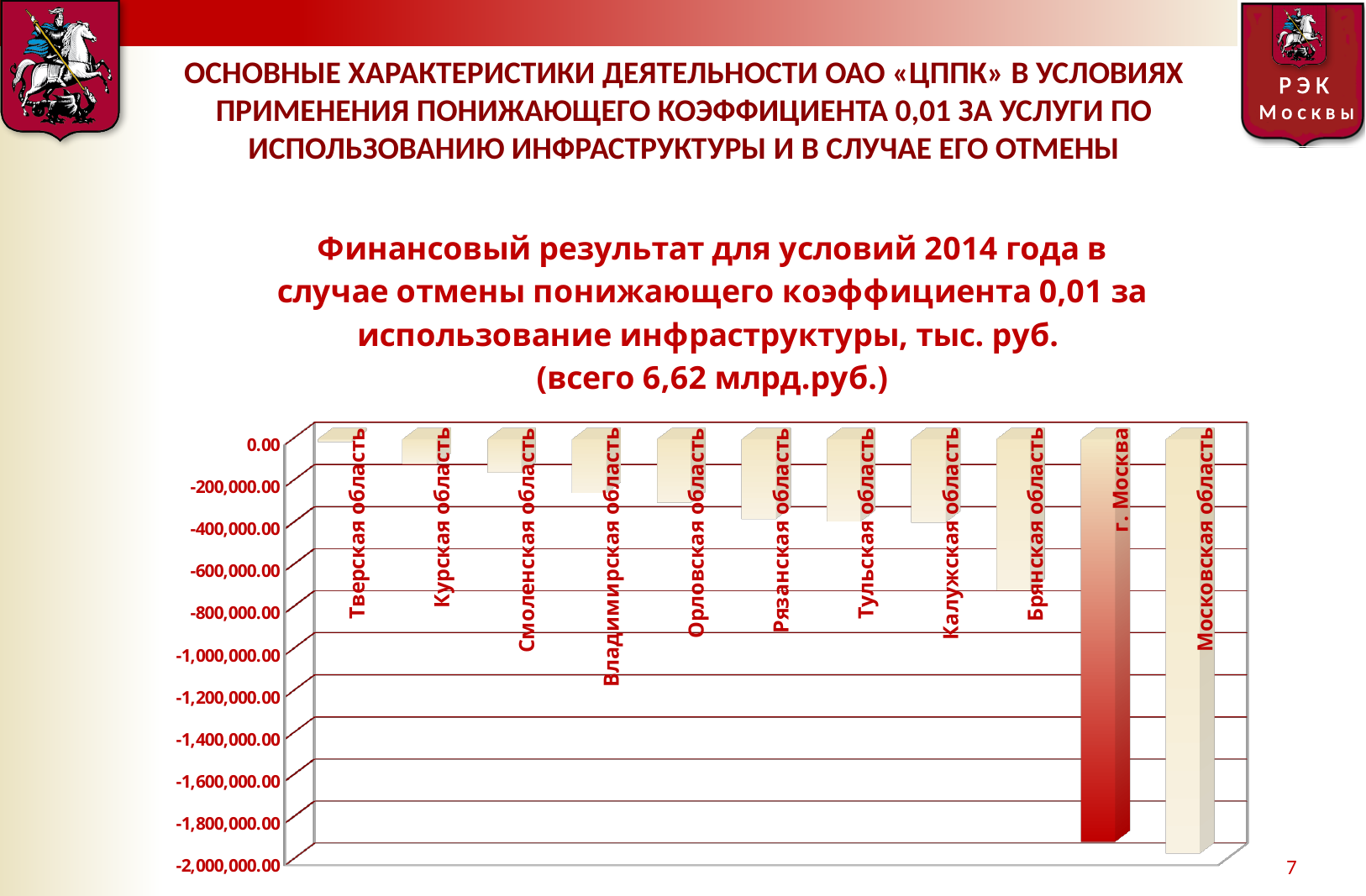
Is the value for г. Москва greater or less than -1,600,000.00? less According to the chart title, what is the total financial result in billions of rubles? 6,62 млрд.руб. Is the value for Брянская область greater or less than -600,000.00? less Is the value for Рязанская область greater or less than -200,000.00? less Which has the lower (more negative) value, Брянская область or Калужская область? Брянская область What kind of chart is shown on the slide? bar chart How many regions are plotted in the chart? 11 Which region has the value closest to zero (the smallest loss) in the chart? Тверская область Which has the larger (less negative) value, Тверская область or Курская область? Тверская область